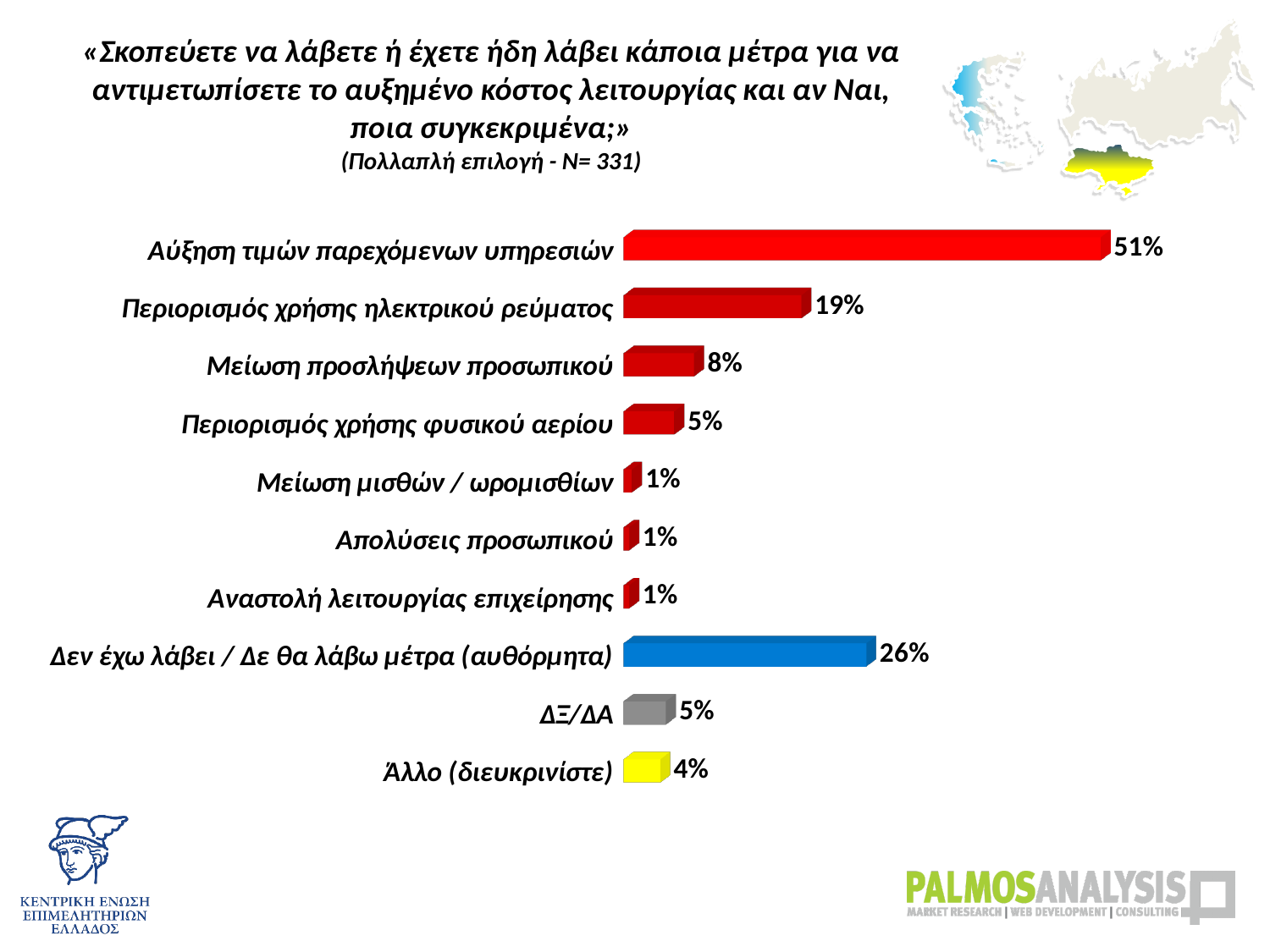
What is the difference in percentage points between «Αύξηση τιμών παρεχόμενων υπηρεσιών» and «Δεν έχω λάβει / Δε θα λάβω μέτρα (αυθόρμητα)»? 25 percentage points What percentage is shown for «Δεν έχω λάβει / Δε θα λάβω μέτρα (αυθόρμητα)»? 26% What percentage is shown for «Αύξηση τιμών παρεχόμενων υπηρεσιών»? 51% How many categories are shown in the chart? 10 What percentage is shown for «Άλλο (διευκρινίστε)»? 4% How many categories show a value of 1%? 3 Which is larger: «Περιορισμός χρήσης ηλεκτρικού ρεύματος» or «Δεν έχω λάβει / Δε θα λάβω μέτρα (αυθόρμητα)»? Δεν έχω λάβει / Δε θα λάβω μέτρα (αυθόρμητα) Which category has the highest percentage? Αύξηση τιμών παρεχόμενων υπηρεσιών What kind of chart is shown on the slide? Bar chart What percentage is shown for «Περιορισμός χρήσης ηλεκτρικού ρεύματος»? 19% What is the sample size (N) stated in the chart subtitle? 331 What is the difference in percentage points between «Περιορισμός χρήσης ηλεκτρικού ρεύματος» and «Μείωση προσλήψεων προσωπικού»? 11 percentage points